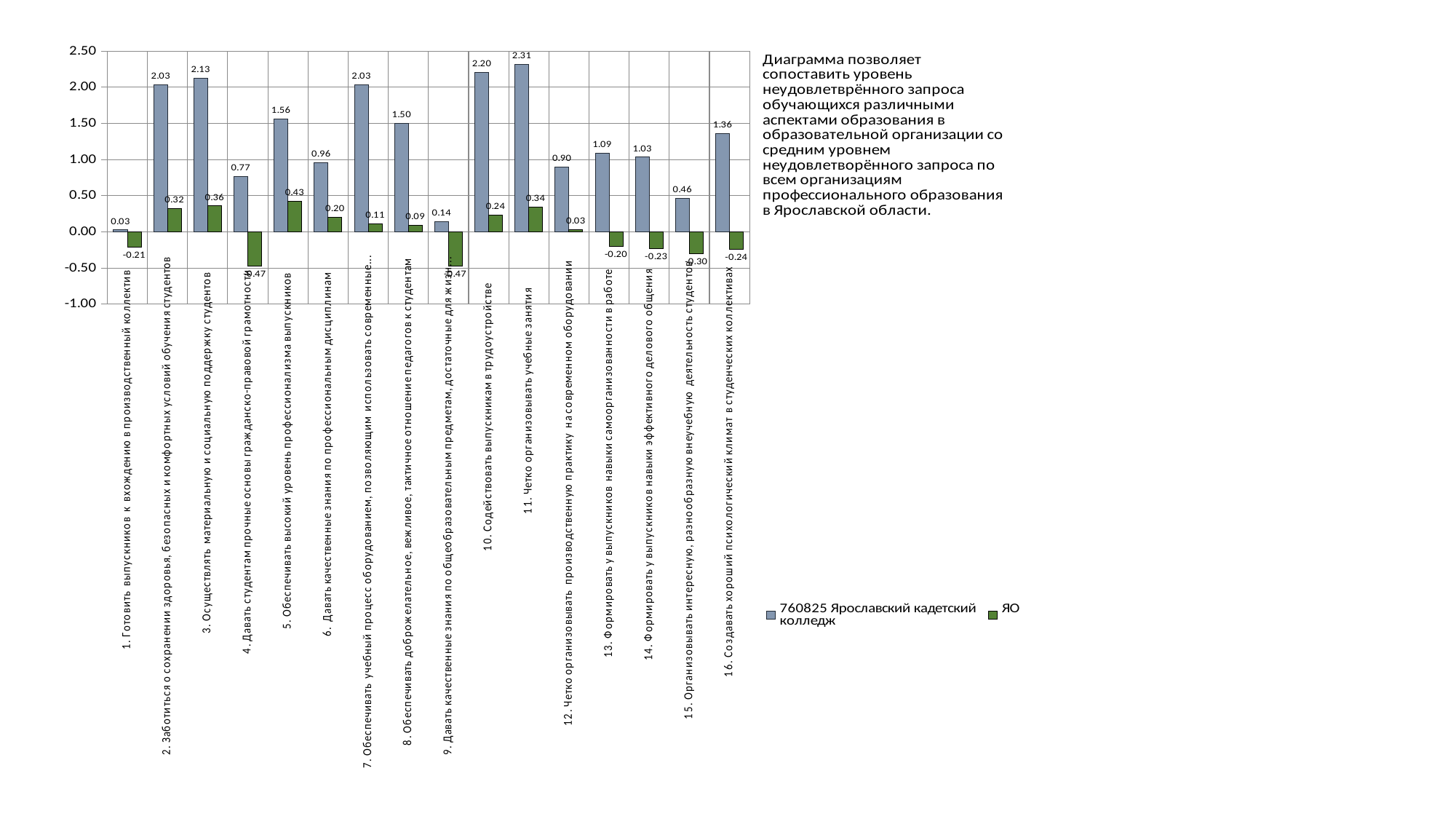
What is the difference between the two series for category '11. Четко организовывать учебные занятия'? 1.97 What is the value for '760825 Ярославский кадетский колледж' for category '16. Создавать хороший психологический климат в студенческих коллективах'? 1.36 Which category has the highest value for the series '760825 Ярославский кадетский колледж'? 11. Четко организовывать учебные занятия What is the value for '760825 Ярославский кадетский колледж' for category '11. Четко организовывать учебные занятия'? 2.31 What type of chart is shown on the slide? Bar chart For the series '760825 Ярославский кадетский колледж', which is larger: category 2 (Заботиться о сохранении здоровья...) or category 3 (Осуществлять материальную и социальную поддержку студентов)? Category 3 (2.13) How many categories are shown on the x axis of the chart? 16 Which category has the lowest value for the series '760825 Ярославский кадетский колледж'? 1. Готовить выпускников к вхождению в производственный коллектив What is the value for 'ЯО' for category '10. Содействовать выпускникам в трудоустройстве'? 0.24 What are the two series names listed in the legend? 760825 Ярославский кадетский колледж; ЯО Which category has the highest value for the series 'ЯО'? 5. Обеспечивать высокий уровень профессионализма выпускников How many series does the legend list? 2